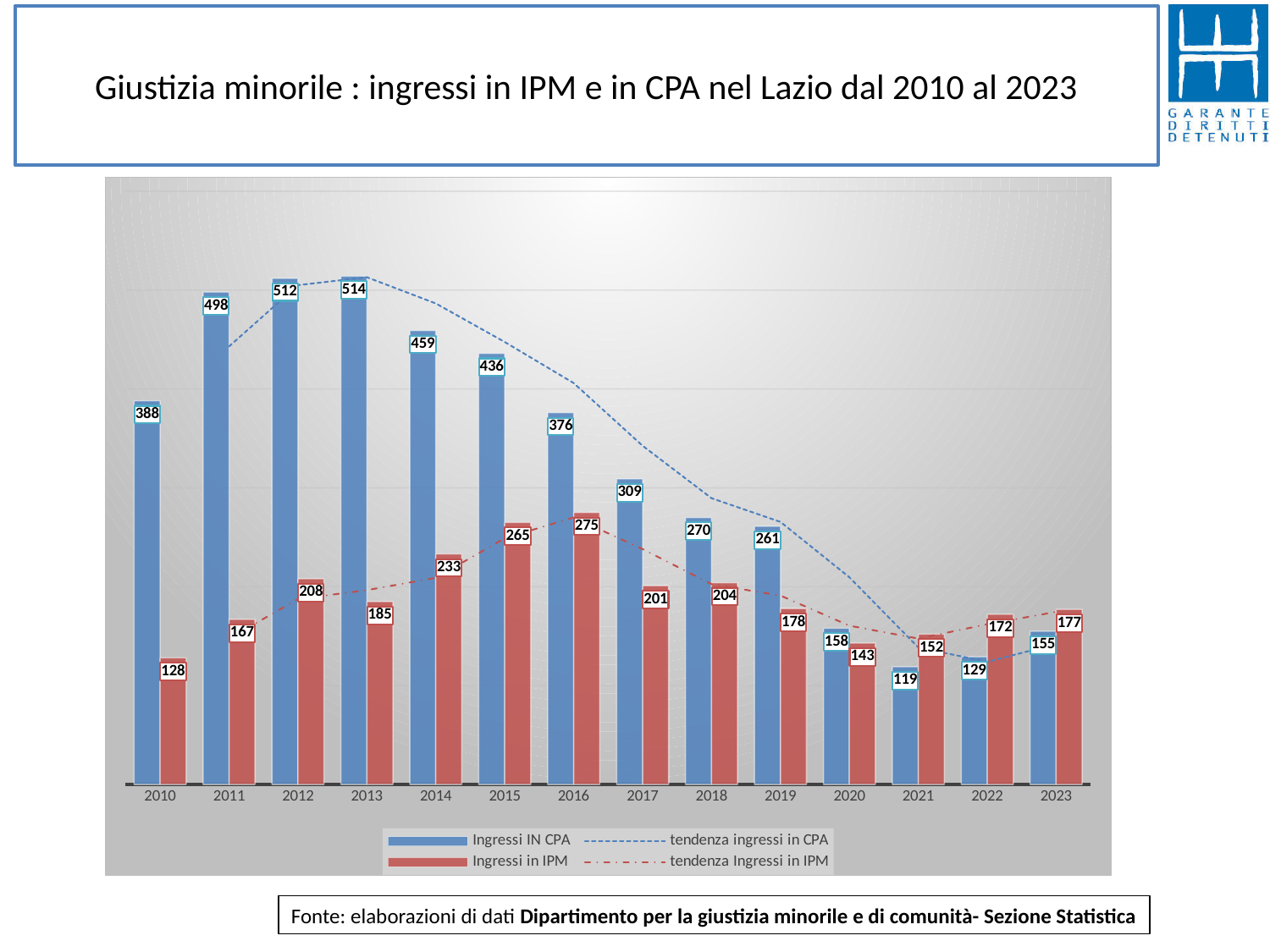
How many years are shown on the x axis? 14 What is the value of Ingressi IN CPA for 2023? 155 How many entries does the legend list? 4 In which year is Ingressi IN CPA lowest? 2021 In 2021, which is larger: Ingressi IN CPA or Ingressi in IPM? Ingressi in IPM What is the value of Ingressi IN CPA for 2013? 514 In which year is Ingressi IN CPA highest? 2013 In which year is Ingressi in IPM lowest? 2010 In which year is Ingressi in IPM highest? 2016 Do the Ingressi IN CPA values rise or fall from 2013 to 2021? fall What is the value of Ingressi in IPM for 2016? 275 What is the difference between Ingressi IN CPA and Ingressi in IPM in 2010? 260